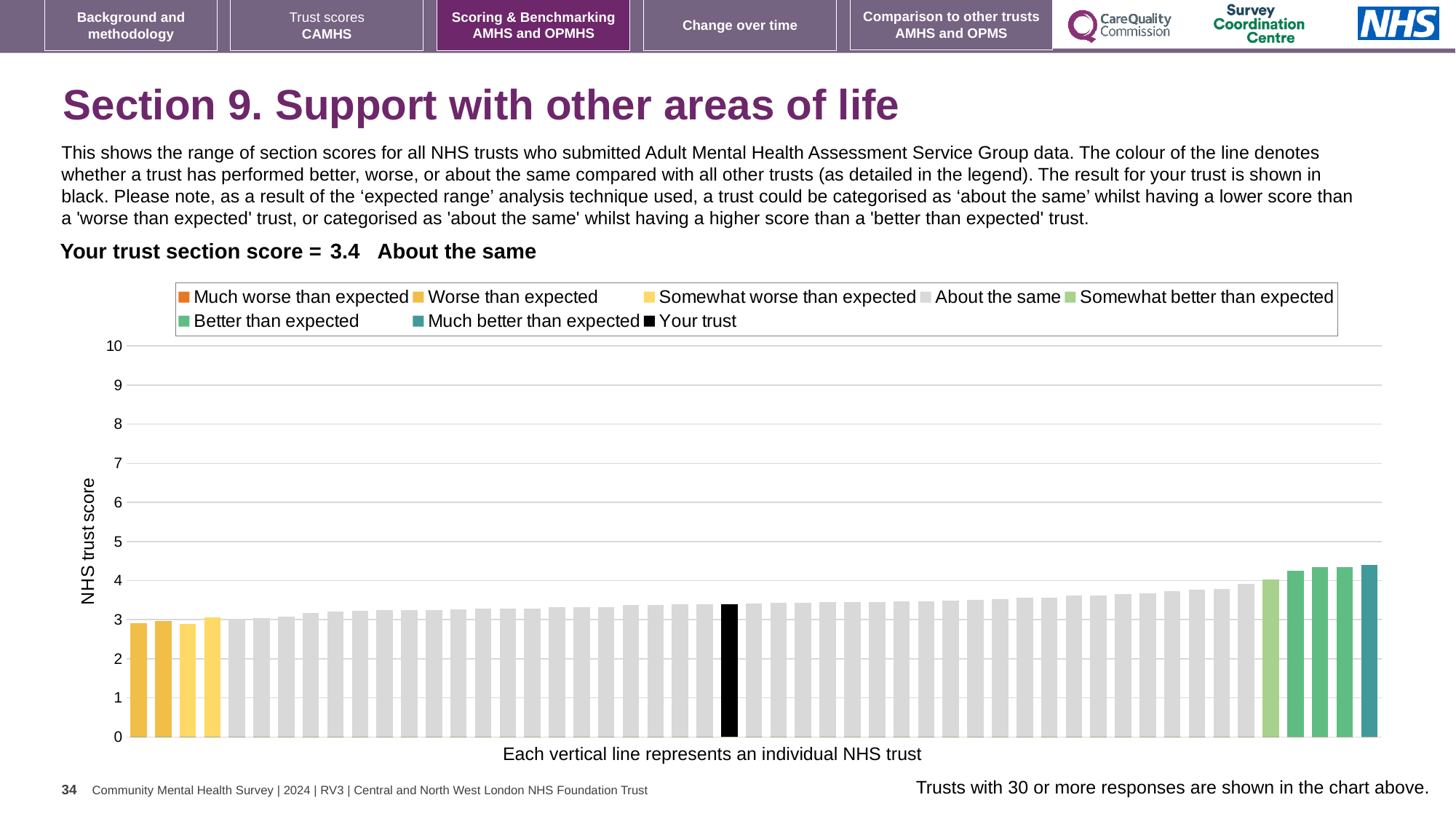
Is the tallest bar in the chart greater or less than 4? greater Which legend category does the tallest bar belong to? Much better than expected What is the label on the y axis of the chart? NHS trust score How many entries does the chart legend list? 8 Do the bar values rise or fall from left to right along the x axis? rise What kind of chart is shown on the slide? bar chart Is the shortest bar in the chart greater or less than 4? less What colour is the bar representing your trust? black Which category is your trust placed in for this section? About the same What is the section score for your trust? 3.4 Is the value for your trust greater or less than 3? greater